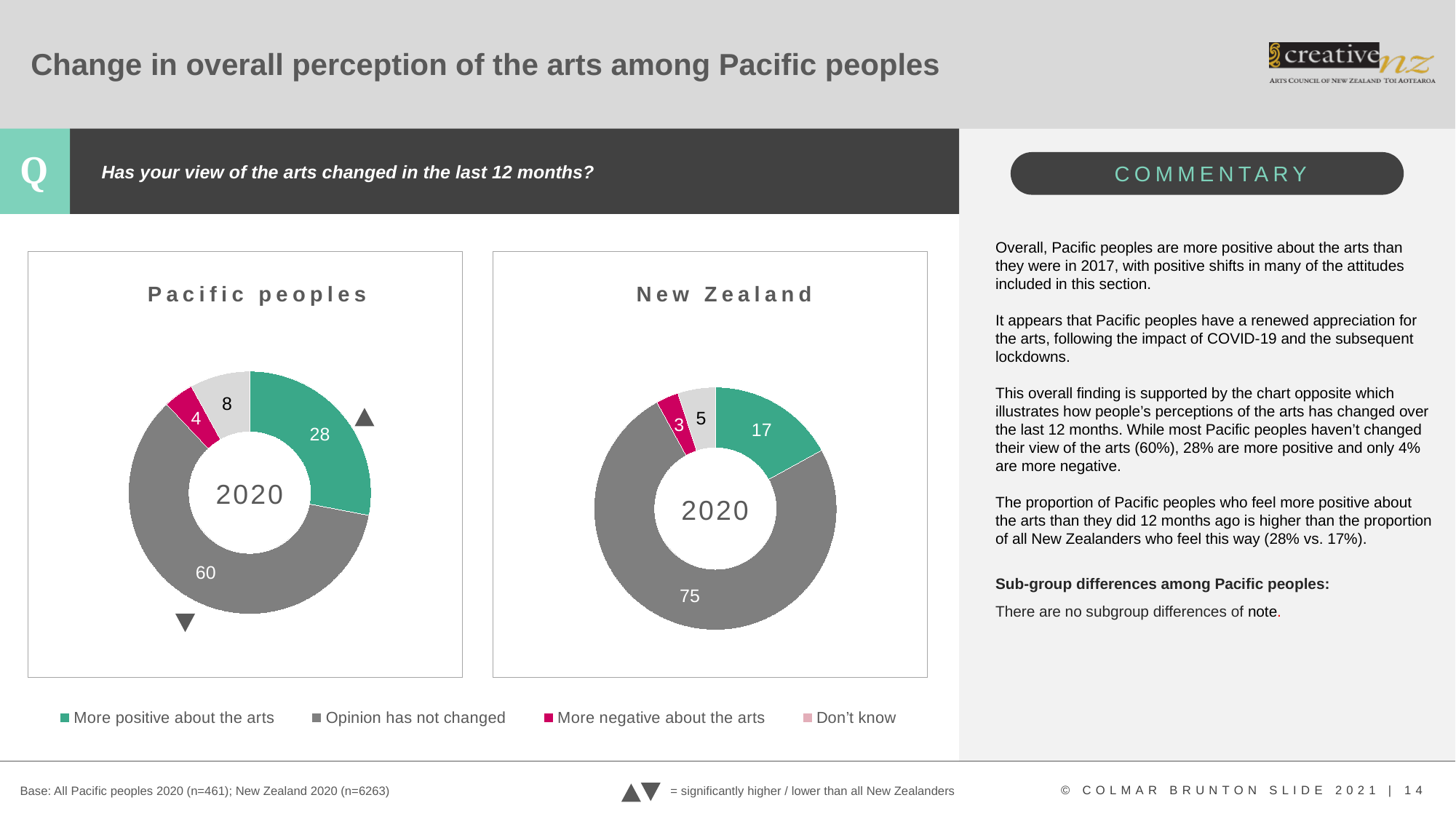
Which chart has the larger value for 'Opinion has not changed', Pacific peoples or New Zealand? New Zealand What year is shown in the centre of the New Zealand chart? 2020 How many categories does the legend list? 4 In the Pacific peoples chart, what is the value for 'Don't know'? 8 In the New Zealand chart, which category has the smallest share? More negative about the arts In the Pacific peoples chart, what is the value for 'More positive about the arts'? 28 In the New Zealand chart, what is the value for 'More negative about the arts'? 3 What kind of chart is used for the Pacific peoples data? Doughnut chart What is the difference between the 'More positive about the arts' values in the Pacific peoples chart and the New Zealand chart? 11 In the New Zealand chart, what is the value for 'Opinion has not changed'? 75 What colour represents 'More negative about the arts' in the charts? Magenta/pink In the Pacific peoples chart, which category has the largest share? Opinion has not changed